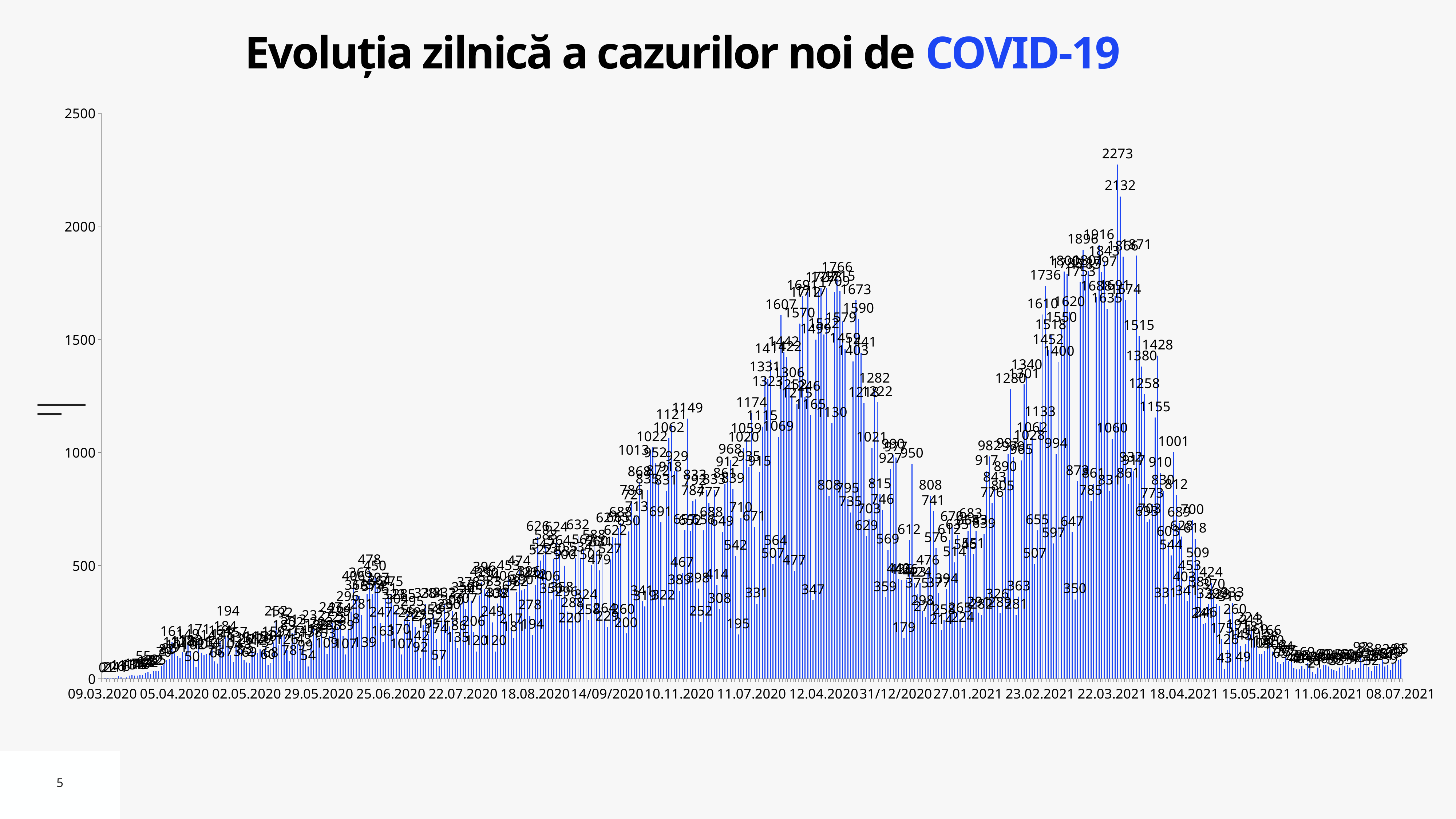
What is the highest daily value labelled on the chart? 2273 What kind of chart is shown on the slide? bar chart What is the title of the chart? Evoluția zilnică a cazurilor noi de COVID-19 Is the tallest bar on the chart greater or less than 2000? greater From the 2273 peak to the right end of the chart (08.07.2021), do the values generally rise or fall? fall What is the value of the local peak labelled just before the 25.06.2020 axis label? 478 Which is larger: the peak of the middle wave labelled 1766 or the overall peak labelled 2273? 2273 Is the value of the last bar at the right end of the chart (08.07.2021) greater or less than 500? less What is the highest tick value shown on the vertical axis? 2500 What is the difference between the two tallest labelled bars, 2273 and 2132? 141 Is the value of the first bar at the left end of the chart (09.03.2020) greater or less than 500? less What is the second-highest value labelled on the chart, next to the 2273 peak? 2132